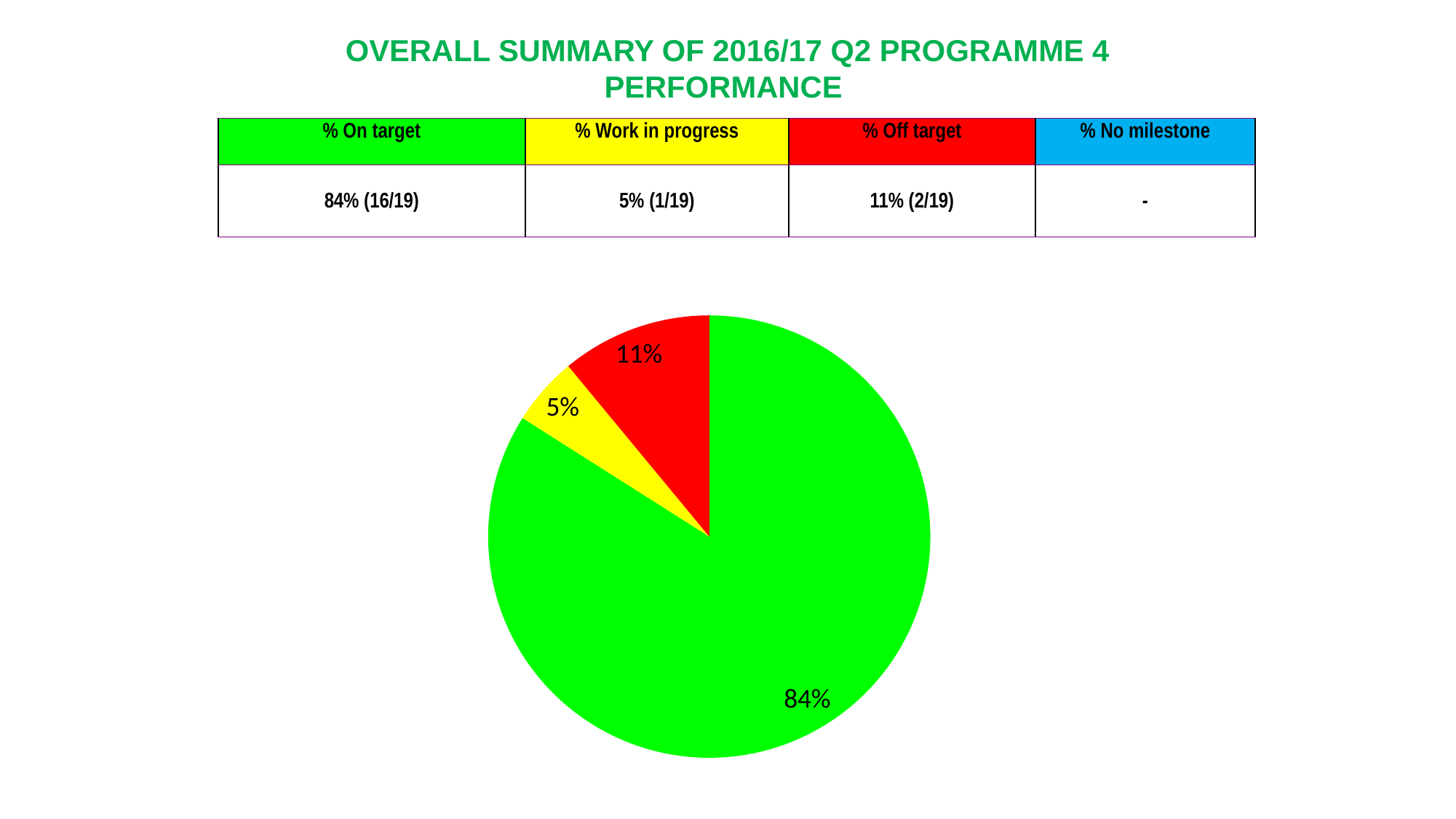
What is the title shown at the top of the slide above the chart? OVERALL SUMMARY OF 2016/17 Q2 PROGRAMME 4 PERFORMANCE According to the table above the pie chart, which category does the green slice represent? % On target What percentage is shown on the green slice of the pie chart? 84% What is the difference between the green slice and the red slice in the pie chart? 73% Which slice of the pie chart is the smallest? the yellow slice (5%) How many slices does the pie chart have? 3 What percentage is shown on the red slice of the pie chart? 11% What percentage is shown on the yellow slice of the pie chart? 5% What is the difference between the red slice and the yellow slice in the pie chart? 6% Which is larger in the pie chart, the red slice or the yellow slice? the red slice Which slice of the pie chart is the largest? the green slice (84%) What kind of chart is shown on the slide? pie chart